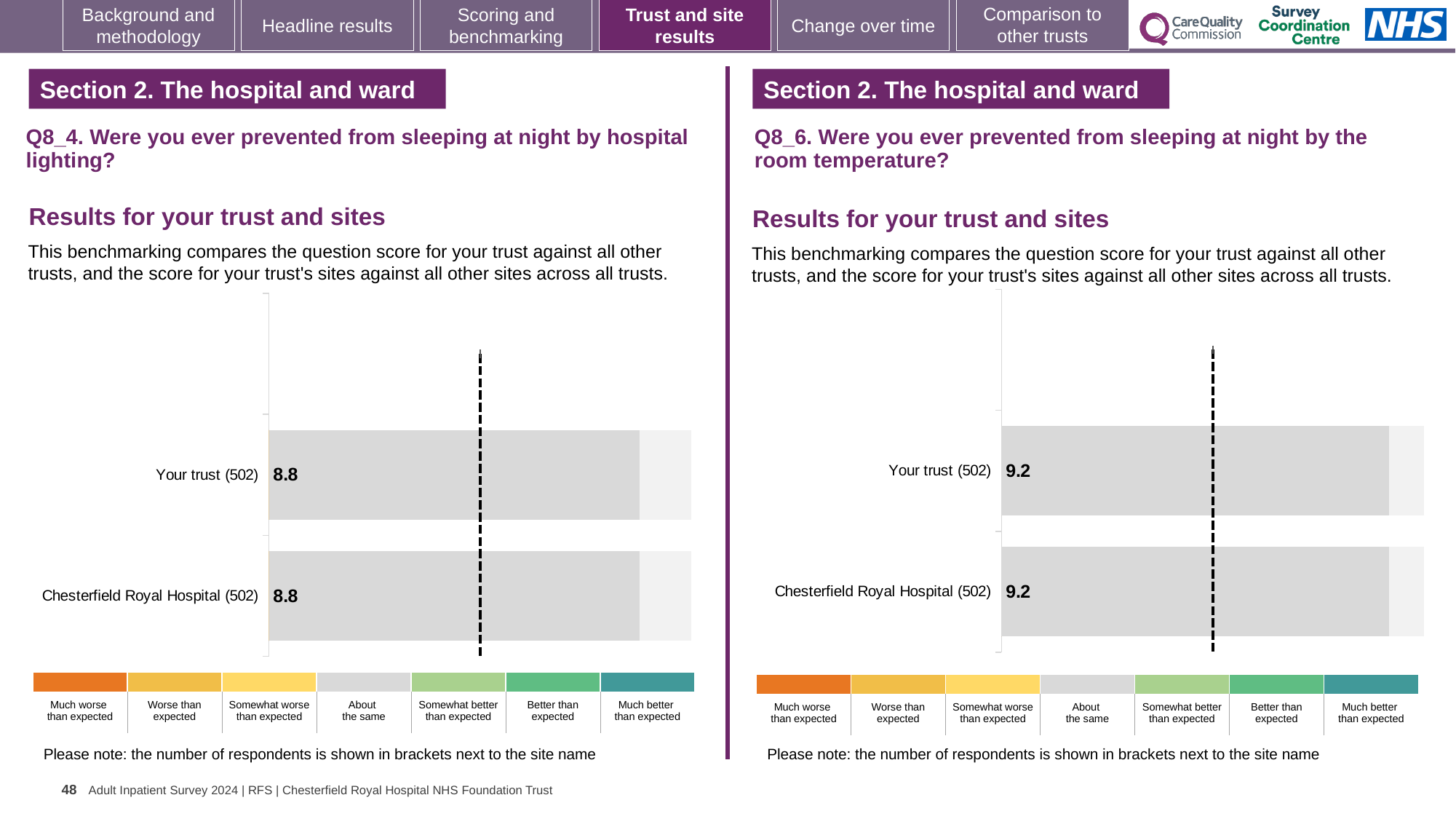
On the Q8_4 chart (hospital lighting), what is the difference between the score for Your trust and the score for Chesterfield Royal Hospital? 0.0 How many bars are plotted on the Q8_4 chart (hospital lighting)? 2 How many benchmark categories are listed in the colour legend below the Q8_6 chart (room temperature)? 7 How many bars are plotted on the Q8_6 chart (room temperature)? 2 On the Q8_4 chart (hospital lighting), what is the score for Your trust (502)? 8.8 On the Q8_6 chart (room temperature), what is the difference between the score for Your trust and the score for Chesterfield Royal Hospital? 0.0 On the Q8_4 chart (hospital lighting), which benchmark category does the grey colour of the bars correspond to in the legend? About the same On the Q8_6 chart (room temperature), what is the score for Chesterfield Royal Hospital (502)? 9.2 On the Q8_4 chart (hospital lighting), what is the score for Chesterfield Royal Hospital (502)? 8.8 On the Q8_6 chart (room temperature), what is the score for Your trust (502)? 9.2 How many respondents are shown in brackets for Chesterfield Royal Hospital on the Q8_6 chart (room temperature)? 502 What kind of chart is used on the Q8_4 chart (hospital lighting)? Bar chart